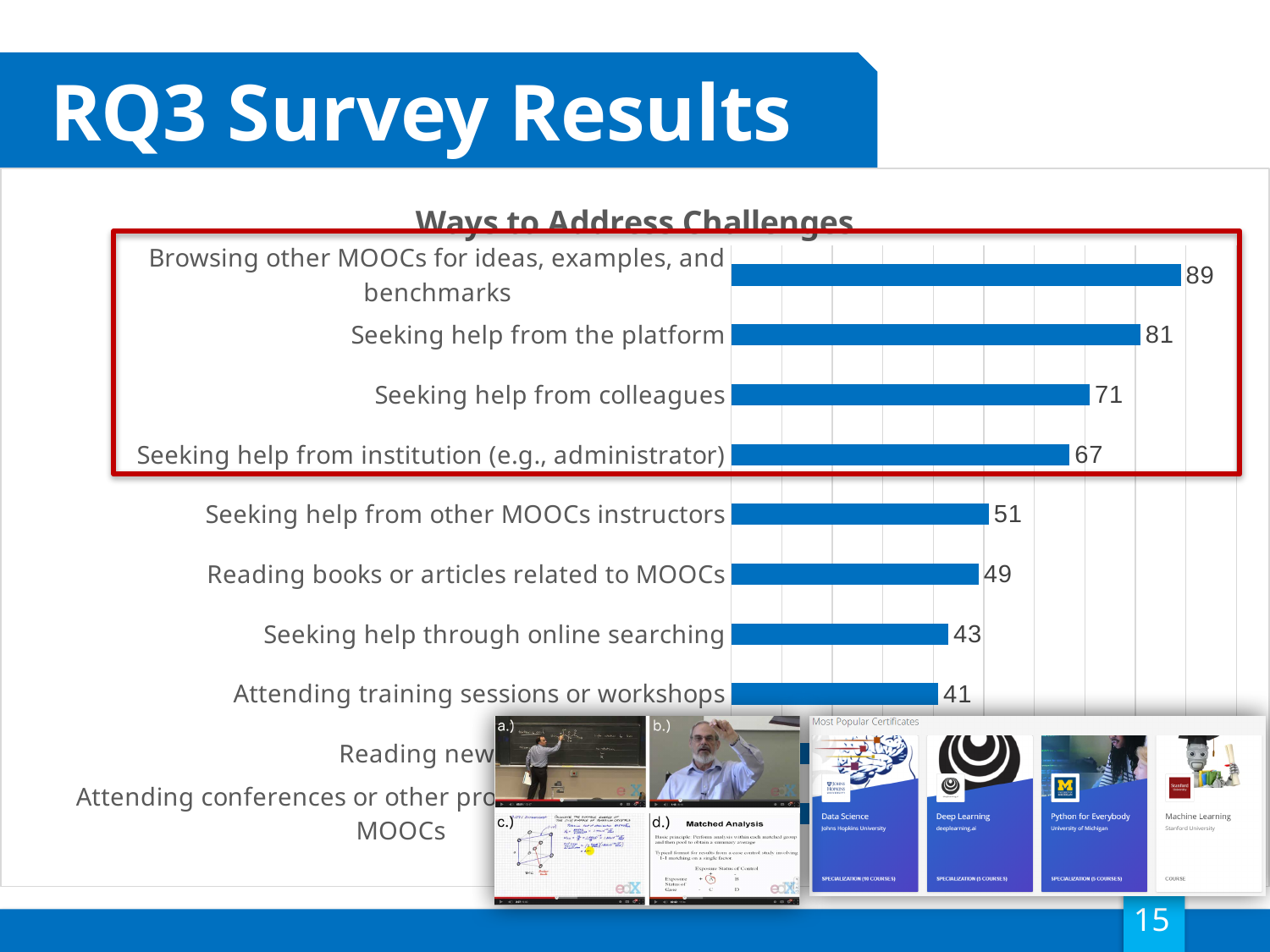
What is the value for "Seeking help from the platform"? 81 What is the difference between the values for "Seeking help from other MOOCs instructors" and "Seeking help through online searching"? 8 Do the bar values increase or decrease going from the top category to the bottom of the chart? Decrease What is the value for "Seeking help from institution (e.g., administrator)"? 67 What is the value for "Attending training sessions or workshops"? 41 What kind of chart is shown on the slide? Bar chart What is the title of the chart? Ways to Address Challenges What is the value for "Seeking help from colleagues"? 71 Which category has the highest value in the chart? Browsing other MOOCs for ideas, examples, and benchmarks What is the value for "Reading books or articles related to MOOCs"? 49 Which is larger: the value for "Seeking help from colleagues" or the value for "Seeking help from other MOOCs instructors"? Seeking help from colleagues What is the difference between the values for "Browsing other MOOCs for ideas, examples, and benchmarks" and "Seeking help from the platform"? 8